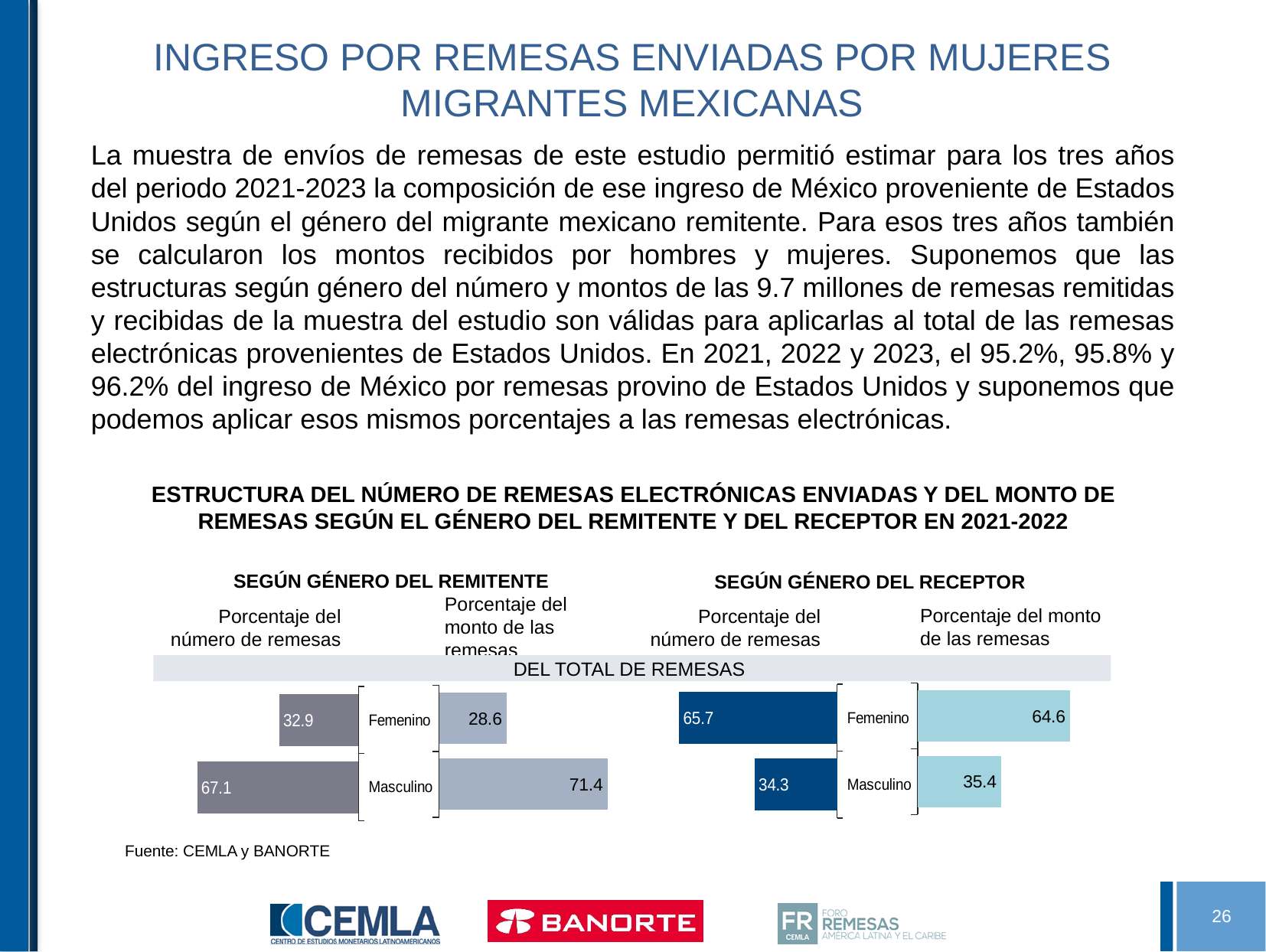
In the 'Según género del receptor' chart, what is the 'Porcentaje del número de remesas' value for Femenino? 65.7 In the 'Según género del receptor' chart, what is the difference between the Femenino and Masculino 'Porcentaje del monto de las remesas' values? 29.2 In the 'Según género del remitente' chart, what is the 'Porcentaje del monto de las remesas' value for Masculino? 71.4 In the 'Según género del remitente' chart, what is the 'Porcentaje del número de remesas' value for Femenino? 32.9 In the 'Según género del remitente' chart, what is the difference between the Masculino and Femenino 'Porcentaje del número de remesas' values? 34.2 In the 'Según género del remitente' chart, which gender has the higher 'Porcentaje del monto de las remesas'? Masculino In the 'Según género del remitente' chart, what is the 'Porcentaje del número de remesas' value for Masculino? 67.1 What kind of chart is used to show the remittance structure by gender? Bar chart In the 'Según género del receptor' chart, what is the 'Porcentaje del monto de las remesas' value for Masculino? 35.4 In the 'Según género del receptor' chart, which gender has the lower 'Porcentaje del número de remesas'? Masculino How many gender categories are shown in each panel of the chart? 2 Is the Femenino 'Porcentaje del monto de las remesas' larger in the 'Según género del remitente' chart or in the 'Según género del receptor' chart? Según género del receptor